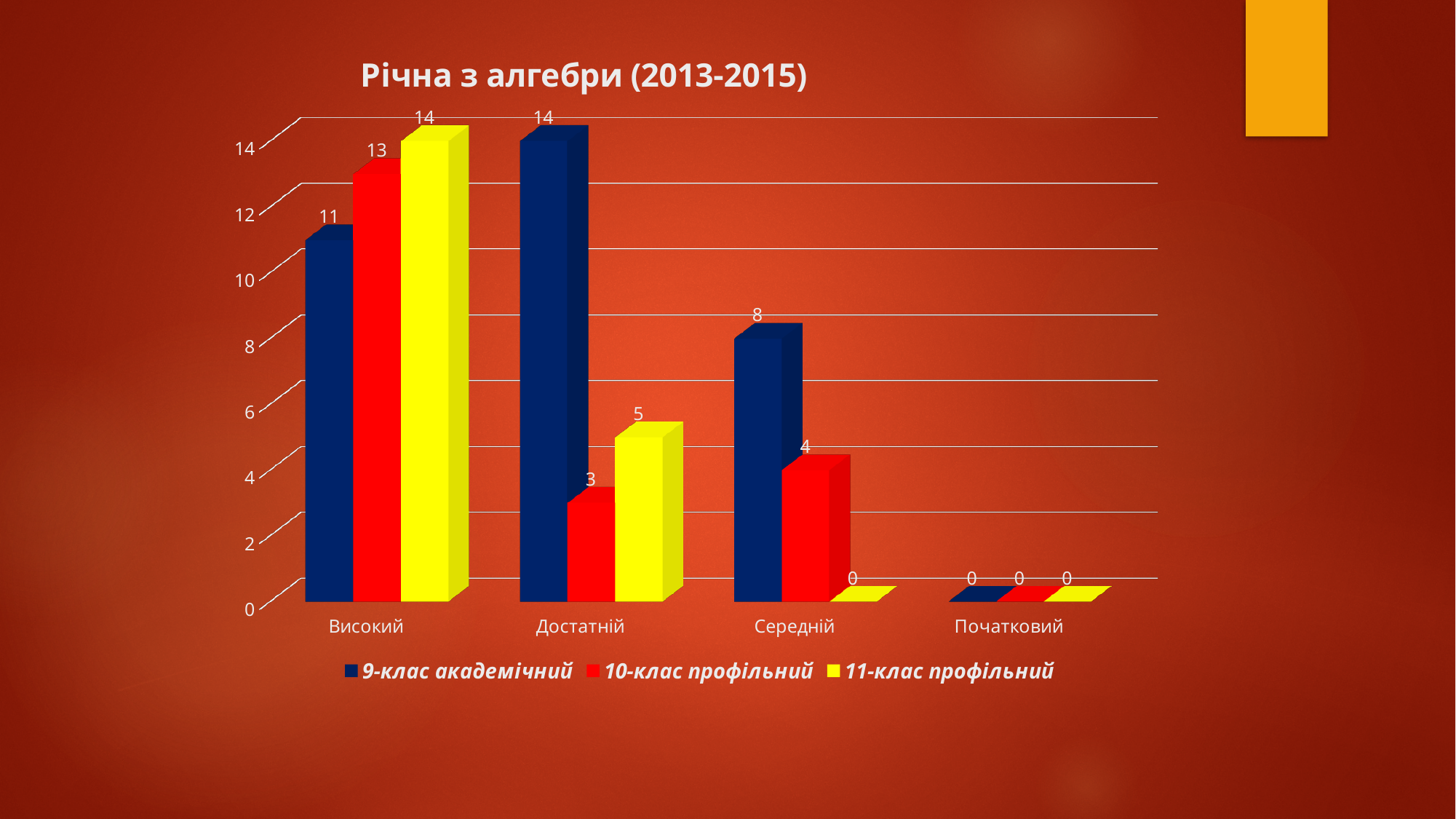
What is the title of the chart? Річна з алгебри (2013-2015) What is the value for 10-клас профільний in the Середній category? 4 Which category has the highest value for 9-клас академічний? Достатній What kind of chart is shown on the slide? Bar chart Which is larger in the Високий category: 10-клас профільний or 11-клас профільний? 11-клас профільний How many series does the legend list? 3 Do the values for 10-клас профільний rise or fall from Високий to Початковий? Fall Which category has the lowest value for 10-клас профільний? Початковий What is the difference between the 9-клас академічний and 10-клас профільний values in the Достатній category? 11 What is the value for 9-клас академічний in the Високий category? 11 How many categories are shown on the x axis? 4 What is the value for 11-клас профільний in the Достатній category? 5